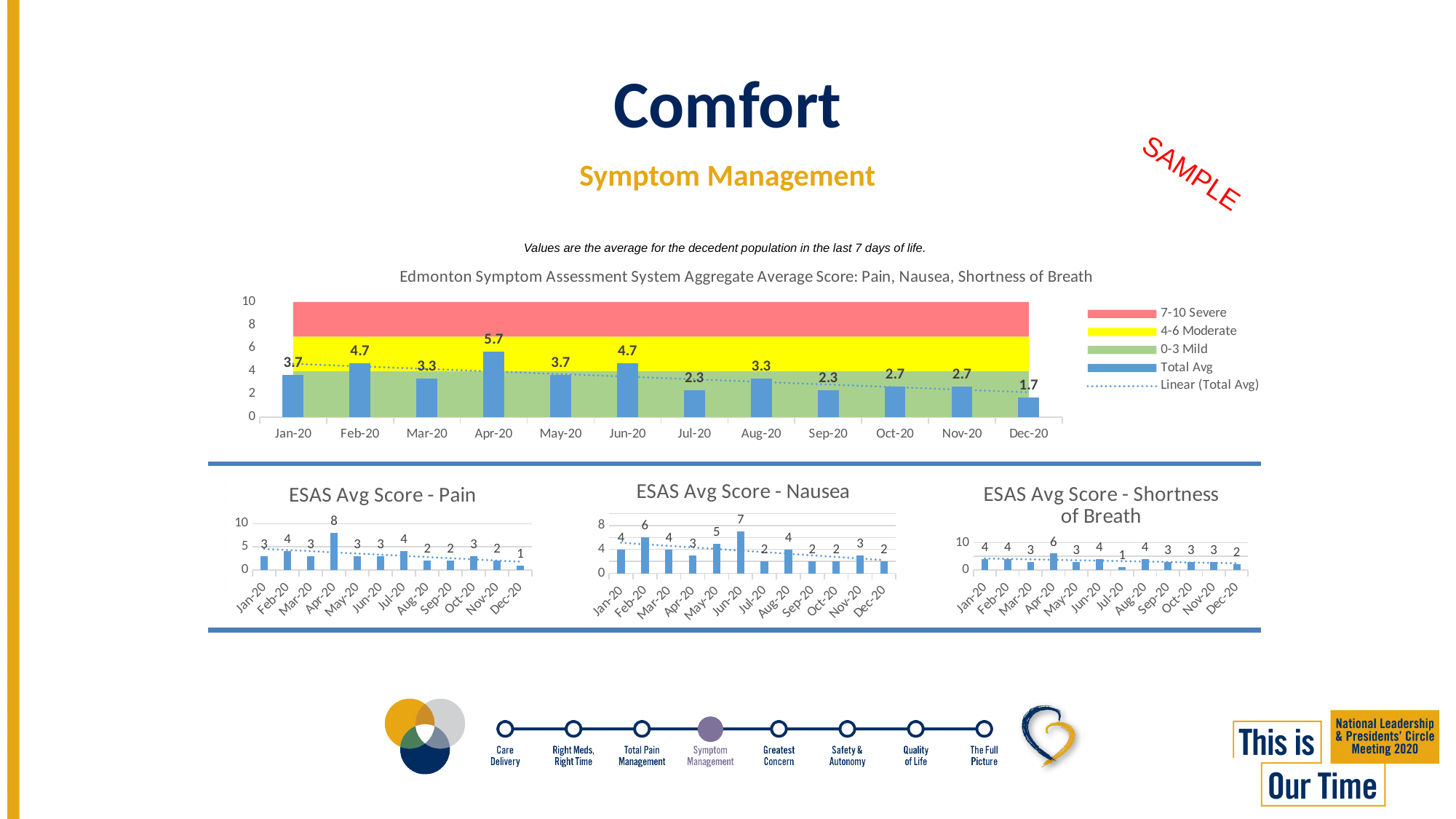
In the Edmonton Symptom Assessment System Aggregate Average Score chart, which month has the highest Total Avg value? Apr-20 In the ESAS Avg Score - Shortness of Breath chart, which is larger, the value for Apr-20 or the value for Jul-20? Apr-20 In the Edmonton Symptom Assessment System Aggregate Average Score chart, which month has the lowest Total Avg value? Dec-20 In the Edmonton Symptom Assessment System Aggregate Average Score chart, does the Total Avg generally rise or fall from Jan-20 to Dec-20? fall In the ESAS Avg Score - Pain chart, which month has the lowest value? Dec-20 In the Edmonton Symptom Assessment System Aggregate Average Score chart, what is the difference between the Total Avg values for Apr-20 and Dec-20? 4.0 In the ESAS Avg Score - Nausea chart, which month has the highest value? Jun-20 How many months are plotted in the ESAS Avg Score - Shortness of Breath chart? 12 In the ESAS Avg Score - Pain chart, what is the value for Apr-20? 8 In the Edmonton Symptom Assessment System Aggregate Average Score chart, how many entries does the legend list? 5 In the Edmonton Symptom Assessment System Aggregate Average Score chart, what is the Total Avg value for Apr-20? 5.7 In the ESAS Avg Score - Nausea chart, what is the difference between the values for Feb-20 and Dec-20? 4